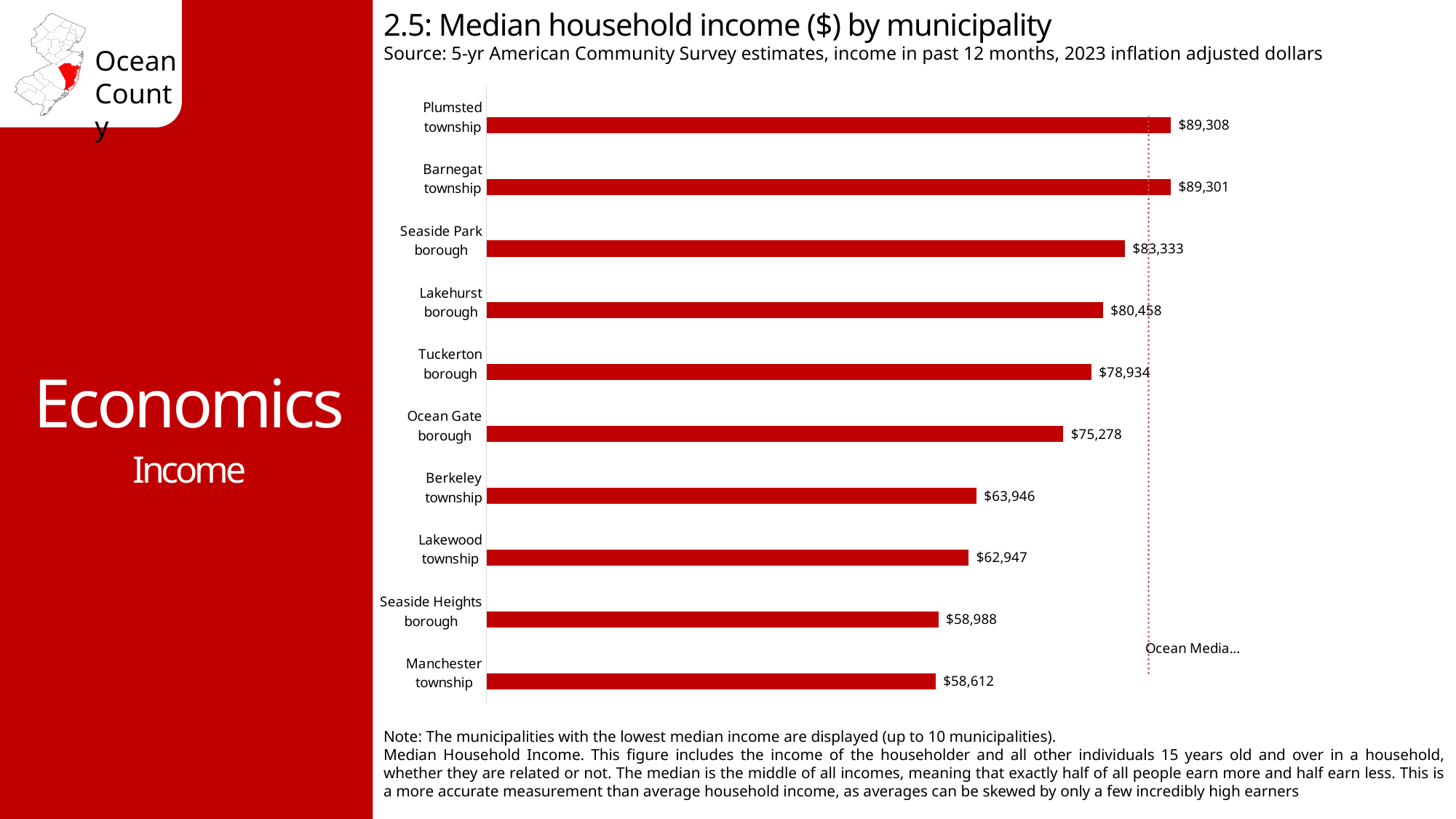
Which municipality has the highest median household income shown on the chart? Plumsted township Which has a higher median household income, Ocean Gate borough or Berkeley township? Ocean Gate borough What is the difference in median household income between Plumsted township and Manchester township? $30,696 What is the median household income for Lakehurst borough? $80,458 What is the median household income for Seaside Heights borough? $58,988 What kind of chart is used to show median household income by municipality? Bar chart What is the title of the chart? 2.5: Median household income ($) by municipality Which has a higher median household income, Tuckerton borough or Lakewood township? Tuckerton borough Which municipality has the lowest median household income shown on the chart? Manchester township How many municipalities are shown on the chart? 10 What is the difference in median household income between Seaside Park borough and Ocean Gate borough? $8,055 What is the median household income for Berkeley township? $63,946